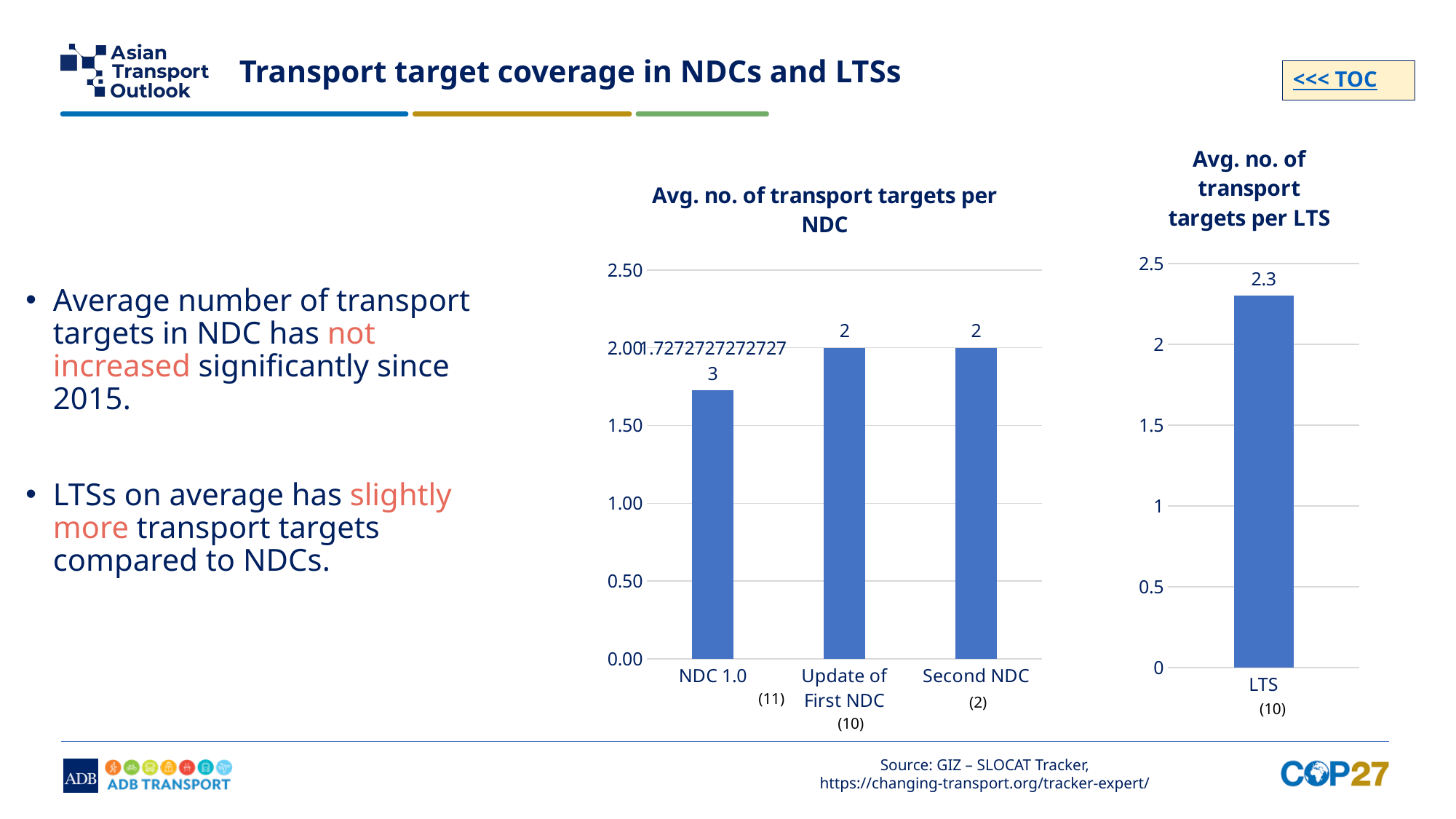
In the 'Avg. no. of transport targets per NDC' chart, what is the value for Second NDC? 2 Which is larger: the value for LTS in the right chart or the value for Second NDC in the left chart? LTS In the 'Avg. no. of transport targets per LTS' chart, what is the value for LTS? 2.3 What is the title of the chart on the right side of the slide? Avg. no. of transport targets per LTS In the 'Avg. no. of transport targets per NDC' chart, which category has the lowest value? NDC 1.0 In the 'Avg. no. of transport targets per NDC' chart, is the value for NDC 1.0 greater or less than 2.00? less How many bars are shown in the 'Avg. no. of transport targets per LTS' chart? 1 How many categories are shown in the 'Avg. no. of transport targets per NDC' chart? 3 What is the difference between the value for LTS in the right chart and the value for Second NDC in the left chart? 0.3 What type of chart is the 'Avg. no. of transport targets per NDC' chart? Bar chart In the 'Avg. no. of transport targets per NDC' chart, is the value for NDC 1.0 greater or less than 1.50? greater In the 'Avg. no. of transport targets per NDC' chart, what is the value for Update of First NDC? 2